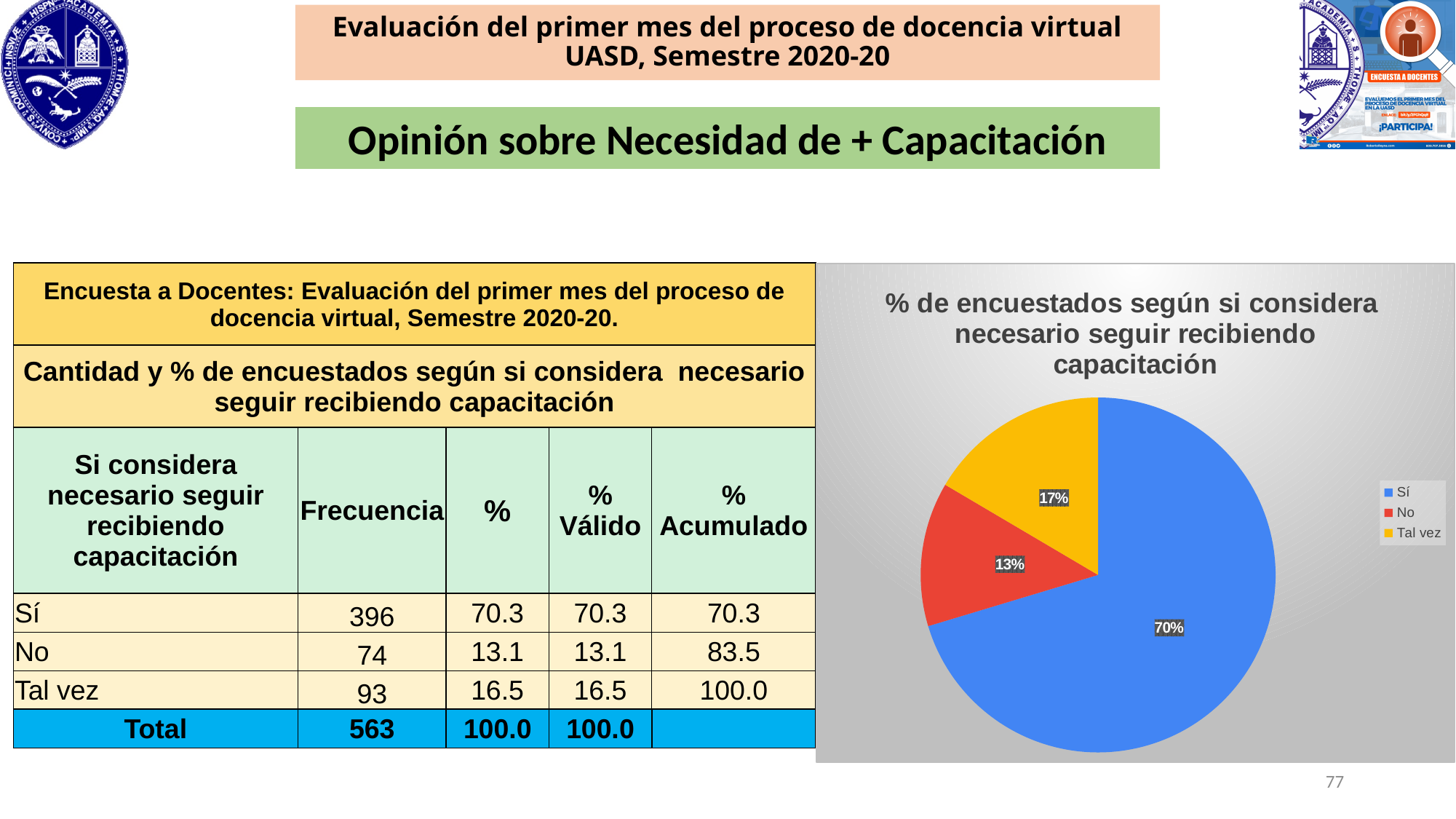
What is the difference in percentage points between the "Sí" slice and the "No" slice in the pie chart? 57 percentage points How many entries does the pie chart legend list? 3 What is the title of the pie chart? % de encuestados según si considera necesario seguir recibiendo capacitación What percentage of the pie chart does the "Tal vez" slice represent? 17% What type of chart is shown on the slide? pie chart How many slices does the pie chart have? 3 What percentage of the pie chart does the "Sí" slice represent? 70% What percentage of the pie chart does the "No" slice represent? 13% Which category has the smallest slice in the pie chart? No What colour is the "Tal vez" slice in the pie chart? yellow Which category has the largest slice in the pie chart? Sí Which slice is larger in the pie chart, "Tal vez" or "No"? Tal vez